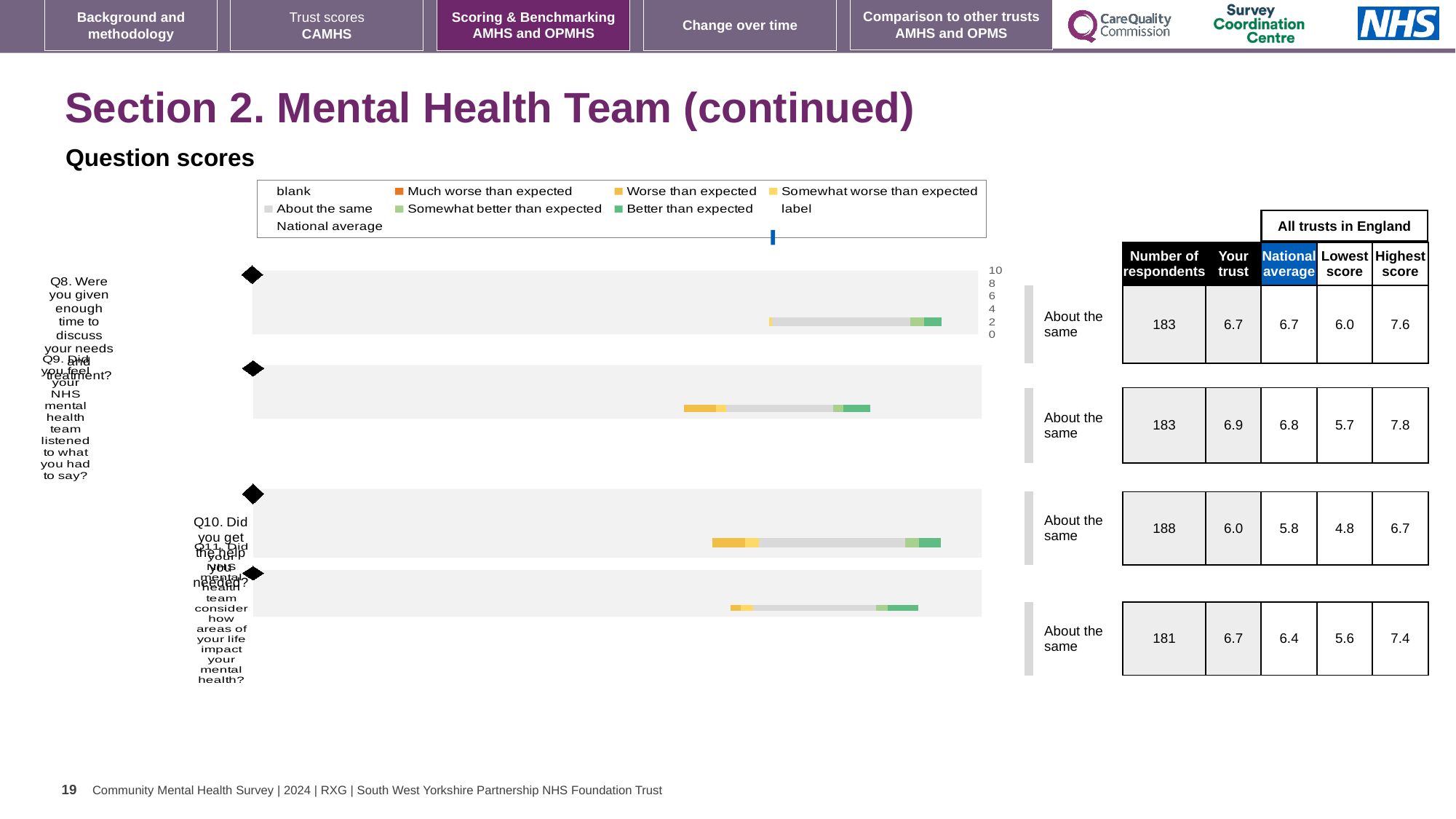
In the table beside the chart, what is the number of respondents for Q8? 183 In the table beside the chart, what is the 'Your trust' score for Q9? 6.9 What kind of chart is shown on the slide? bar chart What colour does the legend use for 'Better than expected'? green In the table beside the chart, what is the highest score for Q11? 7.4 For Q10, which is larger: the 'Your trust' score or the national average? Your trust What is the heading above the chart? Question scores Which question has the highest 'Your trust' score in the table? Q9 Which question has the lowest 'Your trust' score in the table? Q10 How many questions (bars) are plotted in the chart? 4 What is the difference between the highest score and the lowest score for Q9 in the table? 2.1 In the table beside the chart, what is the national average for Q10? 5.8